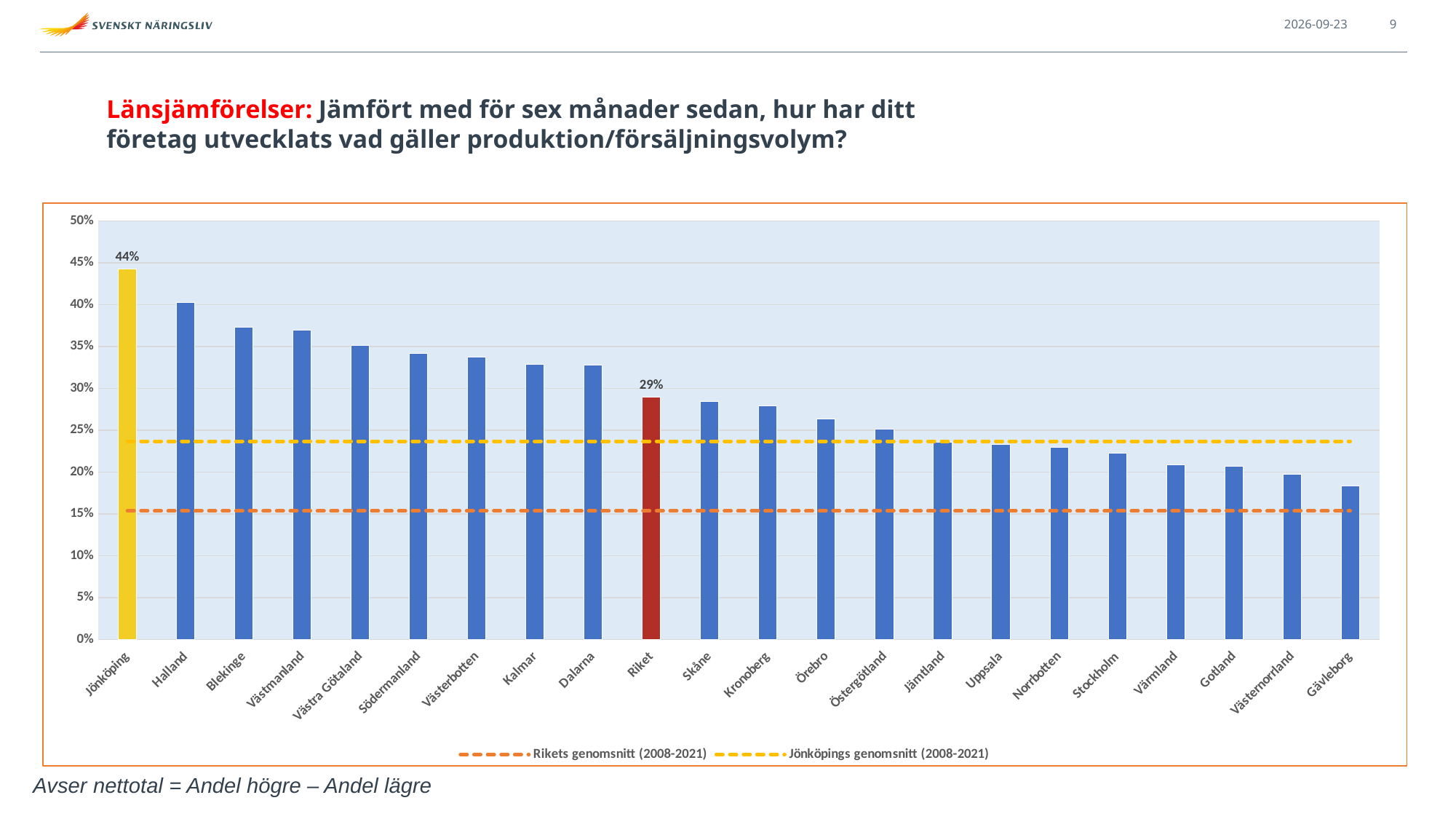
What is the value for Riket? 29% How many categories are shown on the x axis? 22 How many entries does the legend list? 2 Is the value for Gävleborg greater or less than 20%? less Which category has the lowest value? Gävleborg Do the bar values rise or fall from left to right along the x axis? Fall What kind of chart is shown on the slide? Combination bar and line chart (bars with two dashed average lines) Which has a larger value, Halland or Skåne? Halland Is the value for Blekinge greater or less than 35%? greater What is the value for Jönköping? 44% What is the difference between the values for Jönköping and Riket? 15 percentage points Which category has the highest value? Jönköping